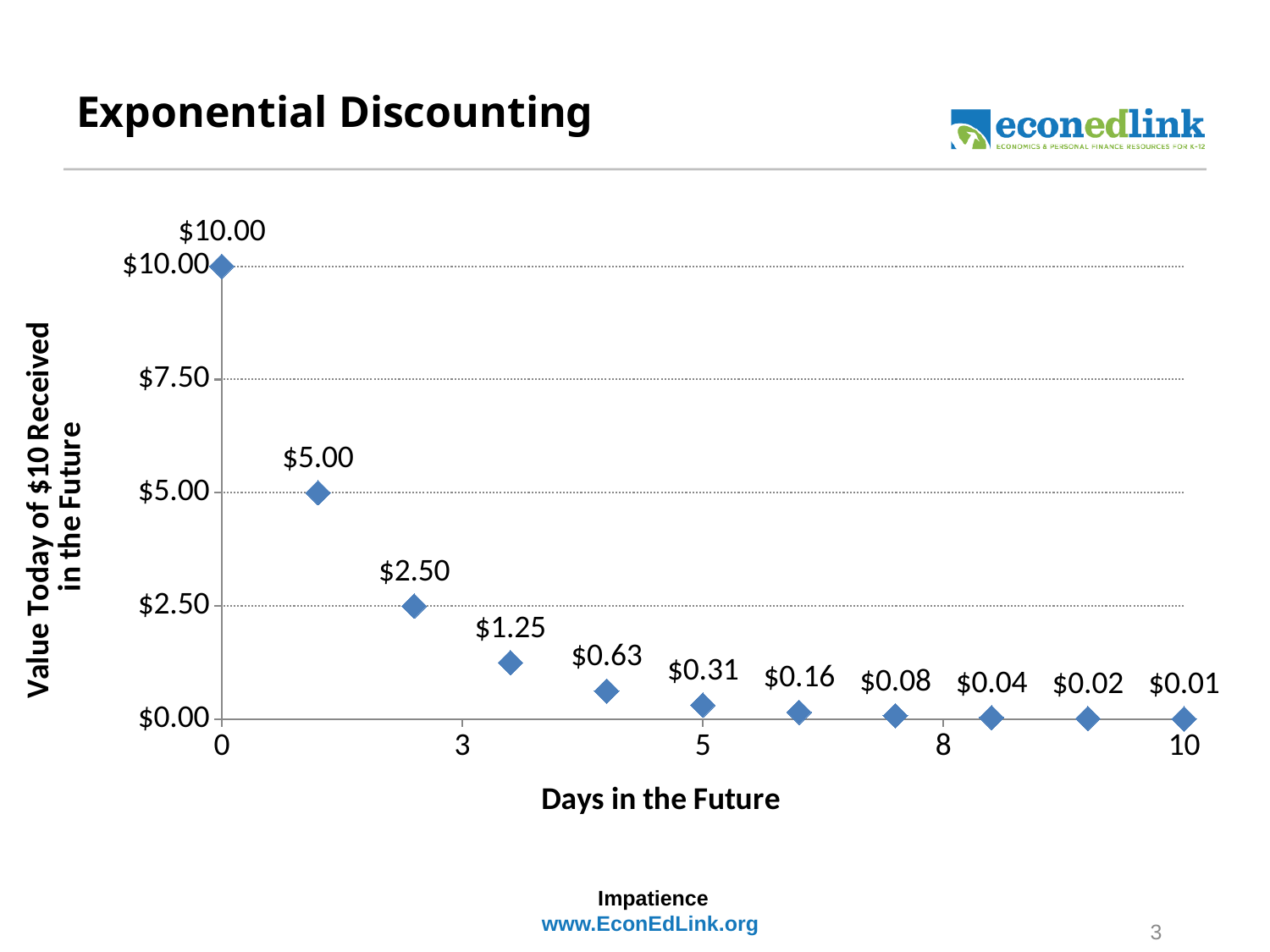
Do the values rise or fall as the number of days in the future increases? Fall What is the value today of $10 received 10 days in the future? $0.01 What is the difference between the value at day 0 and the value at day 5? $9.69 What is the value today of $10 received 5 days in the future? $0.31 What is the value today of $10 received 8 days in the future? $0.04 At which number of days in the future is the value today highest? 0 At which number of days in the future is the value today lowest? 10 What is the value today of $10 received 3 days in the future? $1.25 How many data points are plotted on the chart? 11 What is the value today of $10 received 0 days in the future? $10.00 What kind of chart is shown on the slide? Scatter chart Which is larger, the value at day 3 or the value at day 8? Day 3